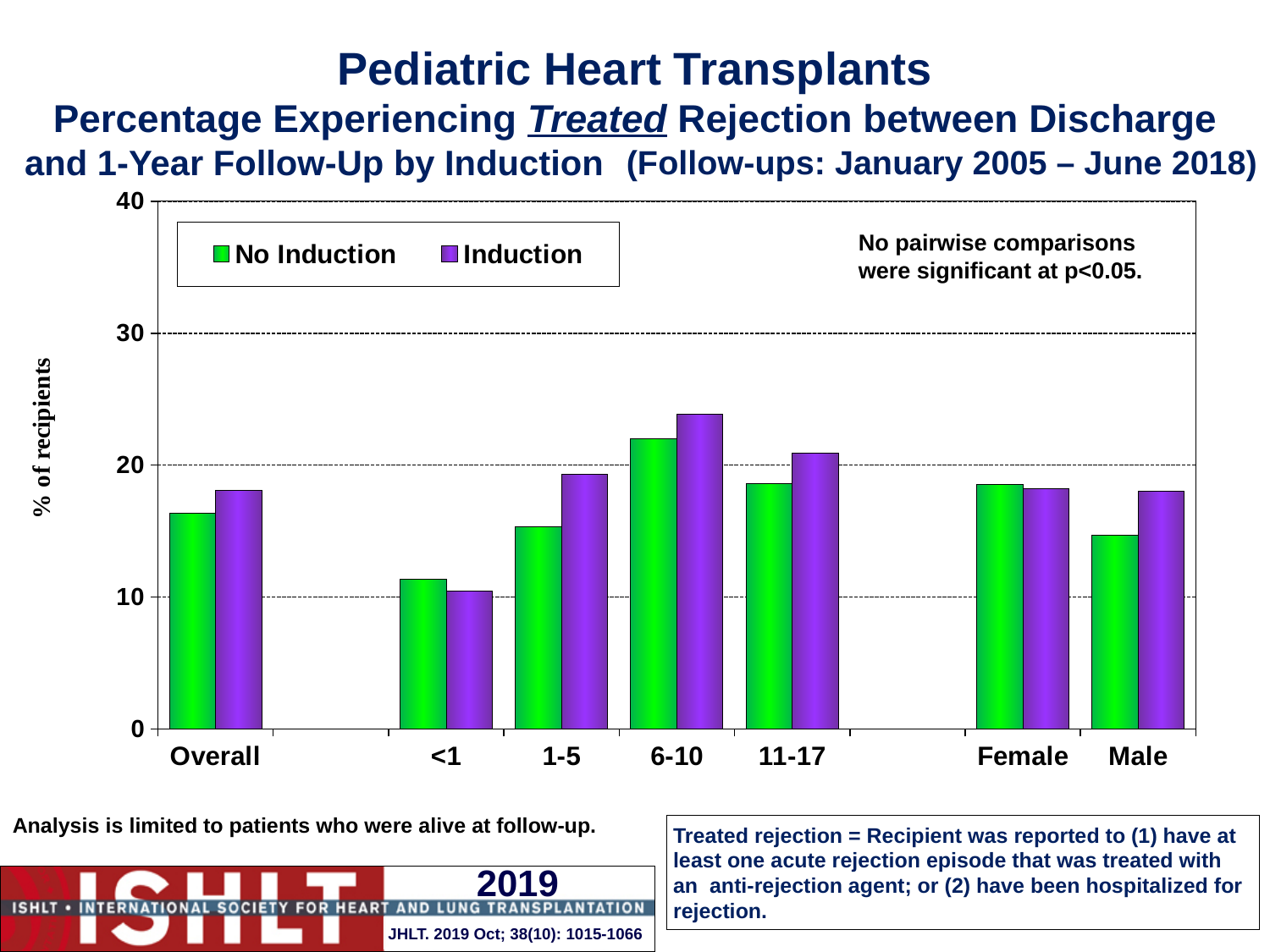
What is the label of the y axis? % of recipients Is the No Induction value for 6-10 greater or less than 20? greater How many categories are shown along the x axis? 7 For the 1-5 age group, which is larger: the No Induction value or the Induction value? Induction Which category has the lowest value for the Induction series? <1 Which category has the lowest value for the No Induction series? <1 Is the Induction value for Overall greater or less than 20? less What kind of chart is shown on the slide? bar chart Which category has the highest value for the No Induction series? 6-10 Is the No Induction value for Male greater or less than 20? less How many series does the legend list? 2 For the Male category, which is larger: the No Induction value or the Induction value? Induction